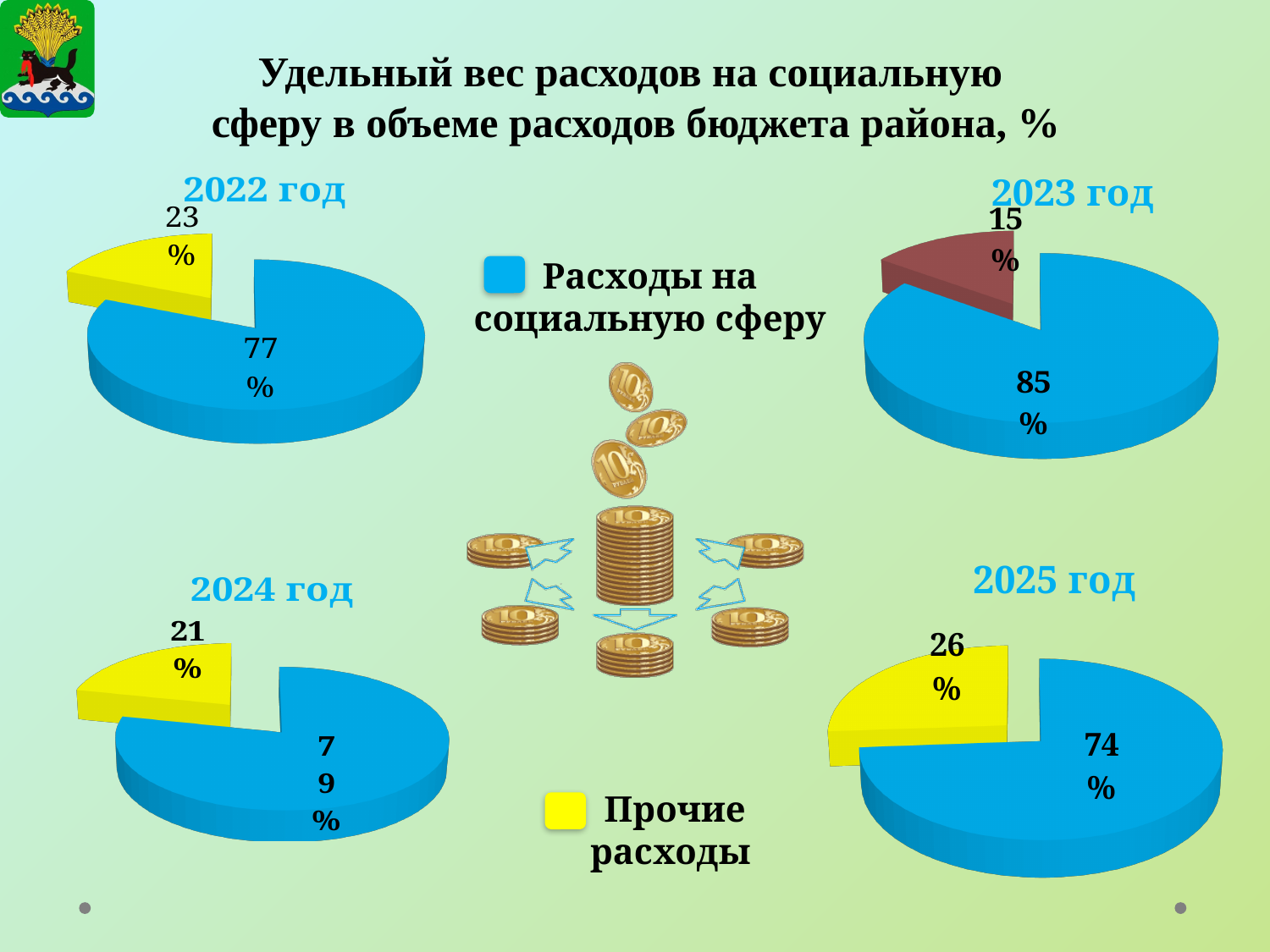
In the 2022 год pie chart, what share is shown for Расходы на социальную сферу (blue slice)? 77% In the 2023 год pie chart, what share is shown for the smaller slice? 15% In the 2023 год pie chart, what share is shown for the blue slice (Расходы на социальную сферу)? 85% What is the difference between the Расходы на социальную сферу share in the 2023 год chart and in the 2022 год chart? 8% How many pie charts are shown on the slide? 4 According to the legend, which category does the blue colour represent? Расходы на социальную сферу What type of chart is used for the 2022 год data? Pie chart Across the four pie charts, which year shows the highest share for Расходы на социальную сферу? 2023 год In the 2025 год pie chart, what share is shown for Прочие расходы (yellow slice)? 26% Which is larger: the Прочие расходы share in the 2024 год chart or in the 2025 год chart? 2025 год Across the four pie charts, which year shows the lowest share for Расходы на социальную сферу? 2025 год In the 2024 год pie chart, what share is shown for Прочие расходы (yellow slice)? 21%